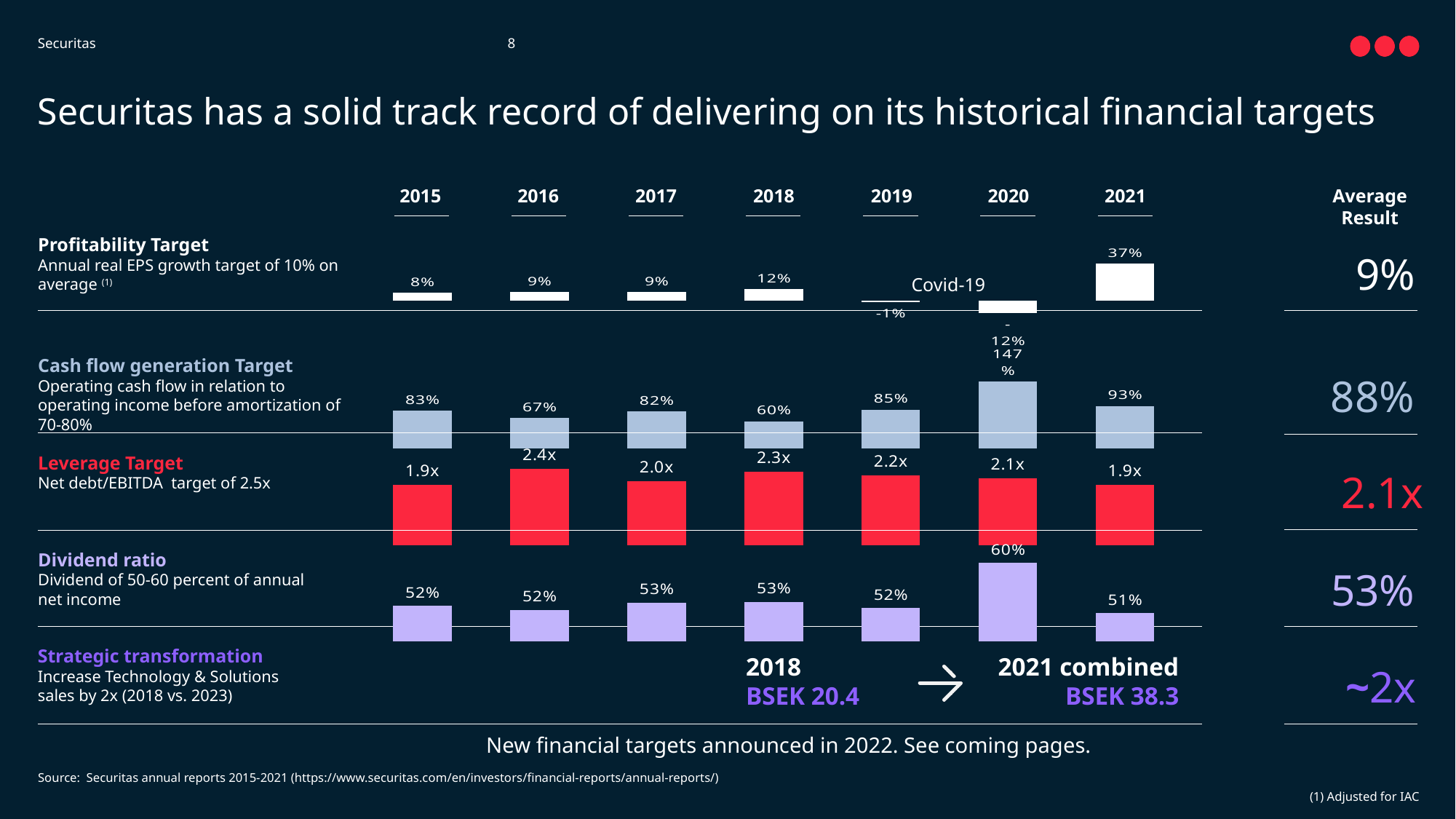
How many years are shown in each chart row? 7 In the Cash flow generation Target chart, which year has the lowest value? 2018 In the Dividend ratio chart, what is the value for 2020? 60% What type of chart is used to show the Dividend ratio values? bar chart In the Profitability Target chart, what is the value for 2021? 37% In the Leverage Target chart, which year has the highest value? 2016 In the Profitability Target chart, what is the difference between the 2018 value and the 2015 value? 4% In the Cash flow generation Target chart, is the value for 2021 larger or smaller than the value for 2017? larger In the Cash flow generation Target chart, what is the value for 2019? 85% In the Leverage Target chart, what is the value for 2016? 2.4x In the Dividend ratio chart, which year has the lowest value? 2021 What is the Average Result shown for the Cash flow generation Target? 88%